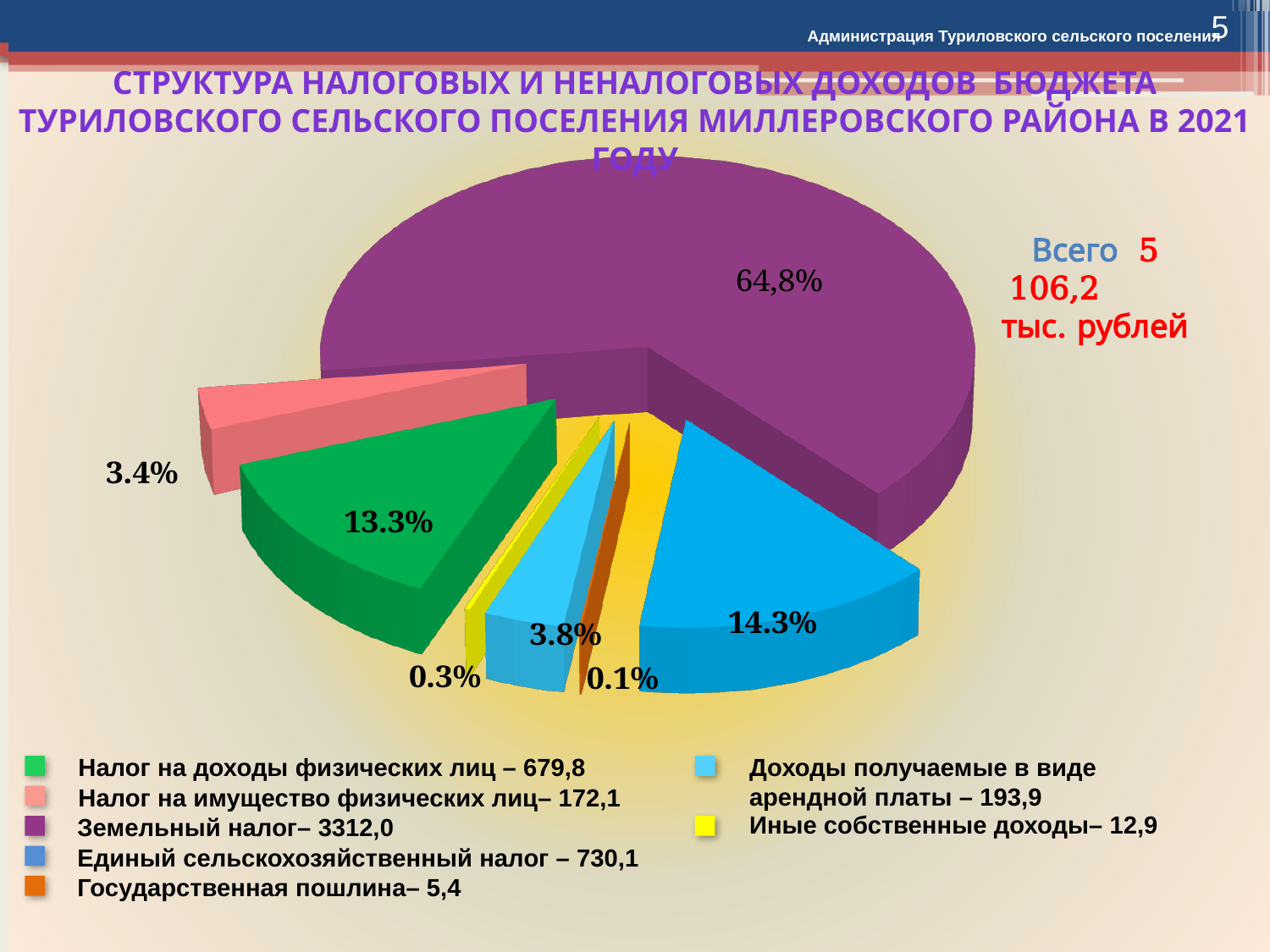
What kind of chart is shown on the slide? pie chart How many slices does the pie chart have? 7 What total amount (Всего) is stated on the slide? 5 106,2 тыс. рублей What percentage is shown for the green slice (Налог на доходы физических лиц)? 13.3% What value does the legend give for Налог на имущество физических лиц? 172,1 What share of the pie does the largest slice (Земельный налог) have? 64,8% Which category has the smallest share of the pie? Государственная пошлина How many entries does the legend list? 7 Which category has the largest share of the pie? Земельный налог What percentage is shown for the blue slice (Единый сельскохозяйственный налог)? 14.3% What value does the legend give for Доходы получаемые в виде арендной платы? 193,9 Which is larger: the share for Единый сельскохозяйственный налог or the share for Налог на доходы физических лиц? Единый сельскохозяйственный налог